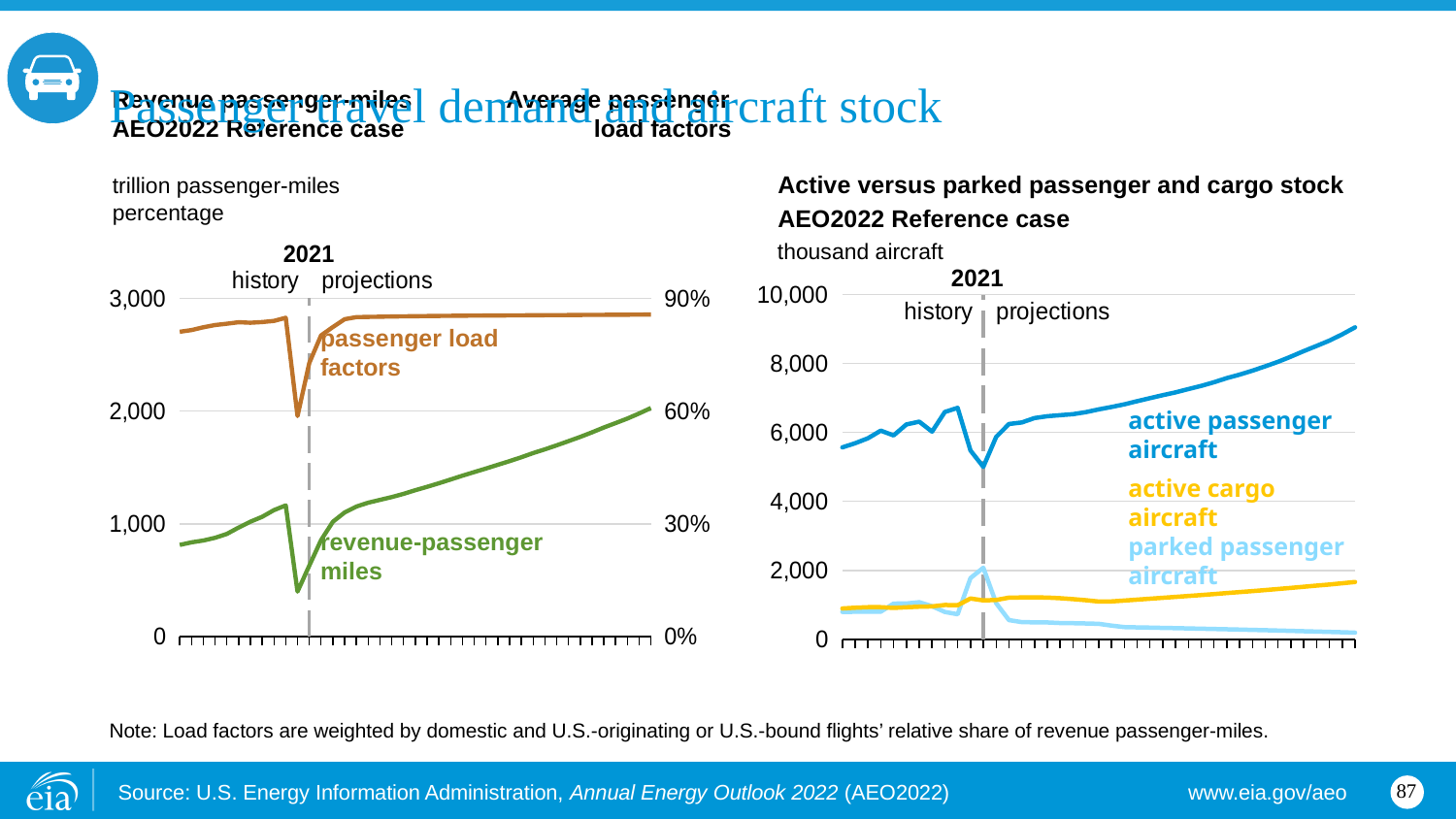
What type of chart is the 'Active versus parked passenger and cargo stock' chart on the right? line chart How many series are plotted on the 'Active versus parked passenger and cargo stock' chart? 3 On the right chart, at the end of the projection period, which is larger: active cargo aircraft or parked passenger aircraft? active cargo aircraft On the right chart, is the value for parked passenger aircraft at the end of the projection period greater or less than 2,000? less On the right chart, is the value for active cargo aircraft at the end of the projection period greater or less than 2,000? less On the right chart, does the active passenger aircraft series rise or fall over the projection period? rise On the left chart, does the revenue-passenger miles series rise or fall over the projection period? rise On the left chart, is the passenger load factor at the end of the projection period greater or less than 60%? greater How many series are plotted on the left chart showing revenue passenger-miles and load factors? 2 On the right chart, does the parked passenger aircraft series rise or fall over the projection period? fall What unit is shown on the y axis of the 'Active versus parked passenger and cargo stock' chart? thousand aircraft